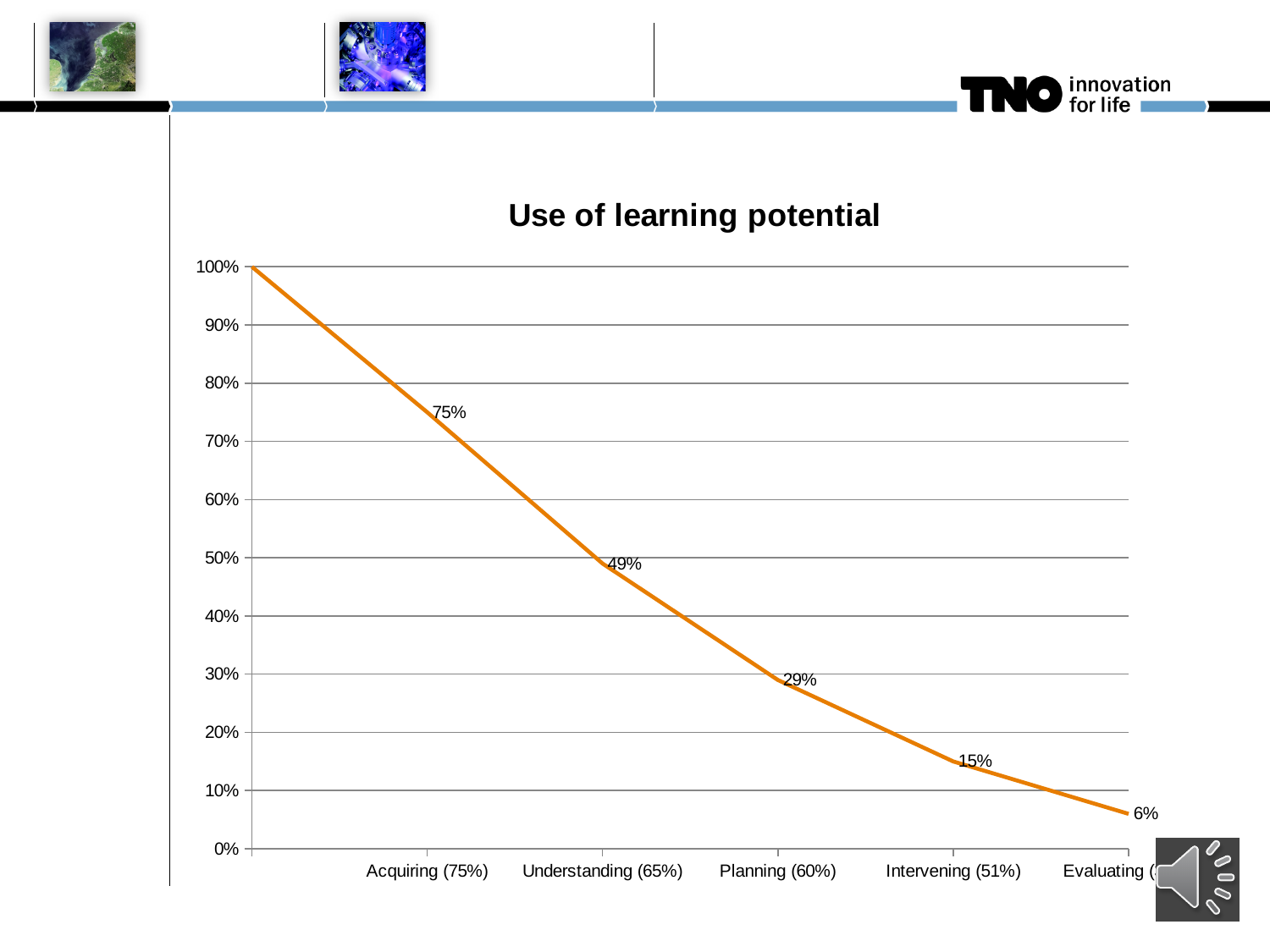
Do the values rise or fall from left to right along the x axis? Fall What is the value of the last point on the line, at Evaluating? 6% What is the difference between the values for Planning (60%) and Intervening (51%)? 14% What is the value plotted for Intervening (51%)? 15% What is the value plotted for Understanding (65%)? 49% Which has the larger plotted value, Understanding (65%) or Planning (60%)? Understanding (65%) Which category has the lowest plotted value? Evaluating What kind of chart is shown on the slide? Line chart Among the categories with printed data labels, which has the highest value? Acquiring (75%) What is the value plotted for Planning (60%)? 29% What is the value plotted for Acquiring (75%)? 75% What is the difference between the values for Acquiring (75%) and Understanding (65%)? 26%